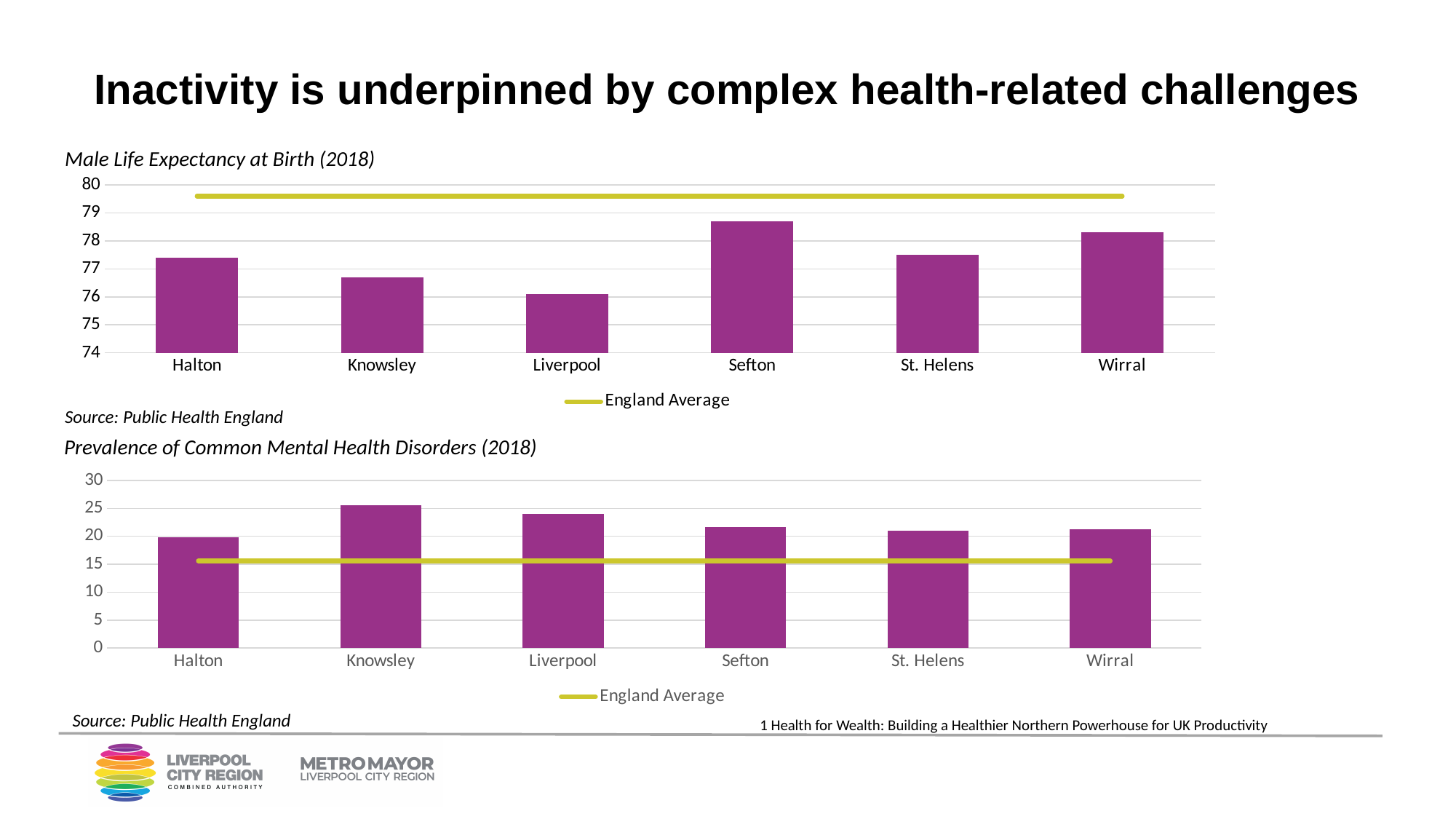
In the Prevalence of Common Mental Health Disorders (2018) chart, is the England Average line greater or less than 20? less What type of chart is the Prevalence of Common Mental Health Disorders (2018) chart? Bar chart In the Prevalence of Common Mental Health Disorders (2018) chart, which area has the highest prevalence? Knowsley How many areas are shown in the Male Life Expectancy at Birth (2018) chart? 6 In the Male Life Expectancy at Birth (2018) chart, which area has the highest male life expectancy? Sefton In the Male Life Expectancy at Birth (2018) chart, which area has the lowest male life expectancy? Liverpool In the Male Life Expectancy at Birth (2018) chart, is the England Average line greater or less than 79? greater In the Male Life Expectancy at Birth (2018) chart, is the value for Sefton greater or less than 78? greater In the Prevalence of Common Mental Health Disorders (2018) chart, which area has the lowest prevalence? Halton In the Male Life Expectancy at Birth (2018) chart, which is higher, Sefton or Liverpool? Sefton In the Prevalence of Common Mental Health Disorders (2018) chart, which is higher, Knowsley or Halton? Knowsley